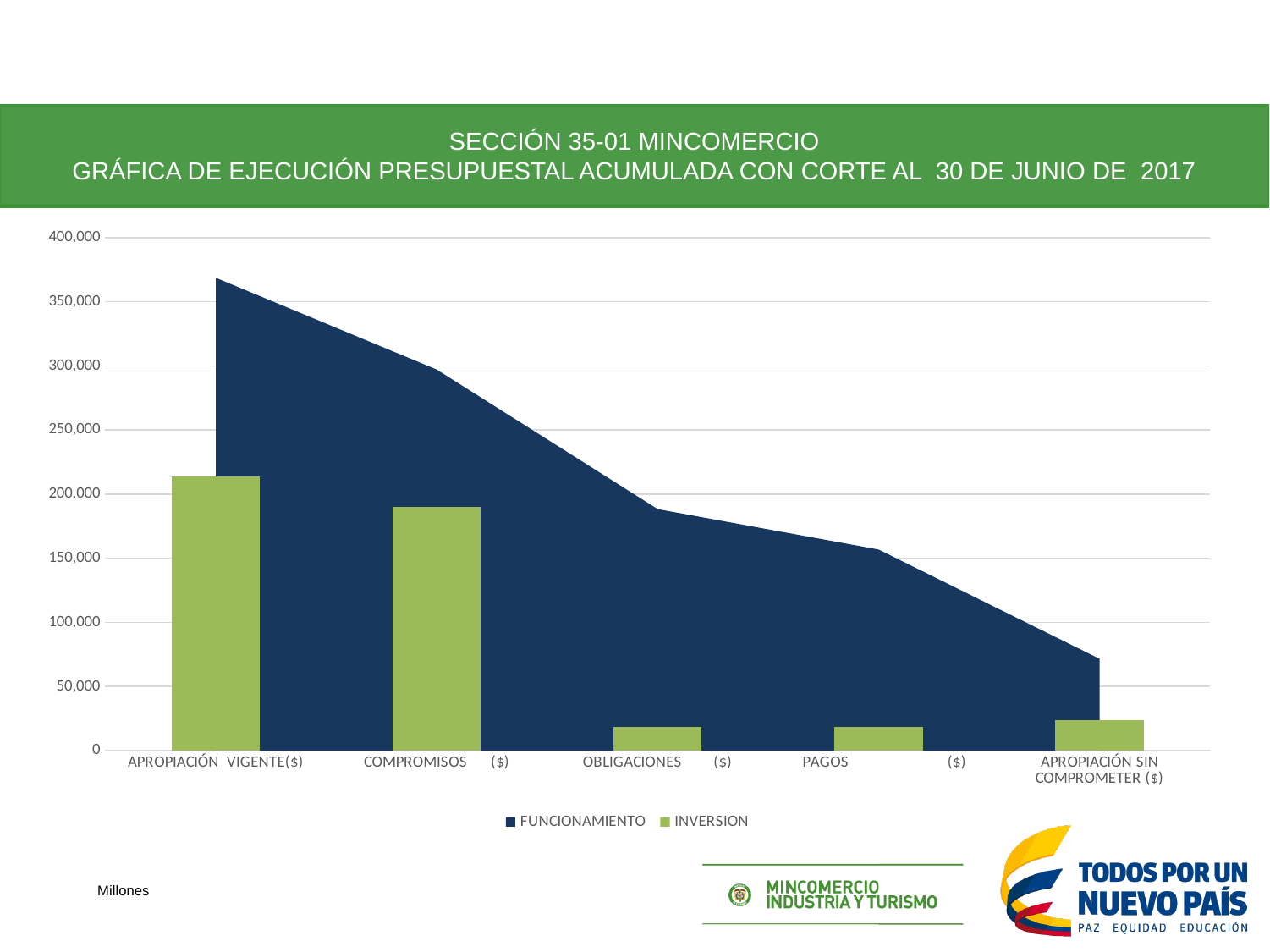
For which category is the FUNCIONAMIENTO value highest? APROPIACIÓN VIGENTE($) For COMPROMISOS ($), which is larger: the FUNCIONAMIENTO value or the INVERSION value? FUNCIONAMIENTO For which category is the INVERSION bar tallest? APROPIACIÓN VIGENTE($) Is the INVERSION value for COMPROMISOS ($) greater or less than 200,000? less How many categories are shown on the x axis of the chart? 5 Which series is drawn as green bars in the chart? INVERSION For which category is the FUNCIONAMIENTO value lowest? APROPIACIÓN SIN COMPROMETER ($) Which series is drawn as the dark blue area in the chart? FUNCIONAMIENTO Is the FUNCIONAMIENTO value for APROPIACIÓN VIGENTE($) greater or less than 350,000? greater Does the FUNCIONAMIENTO series rise or fall from APROPIACIÓN VIGENTE($) to APROPIACIÓN SIN COMPROMETER ($)? fall How many series does the chart legend list? 2 Is the FUNCIONAMIENTO value for APROPIACIÓN SIN COMPROMETER ($) greater or less than 100,000? less